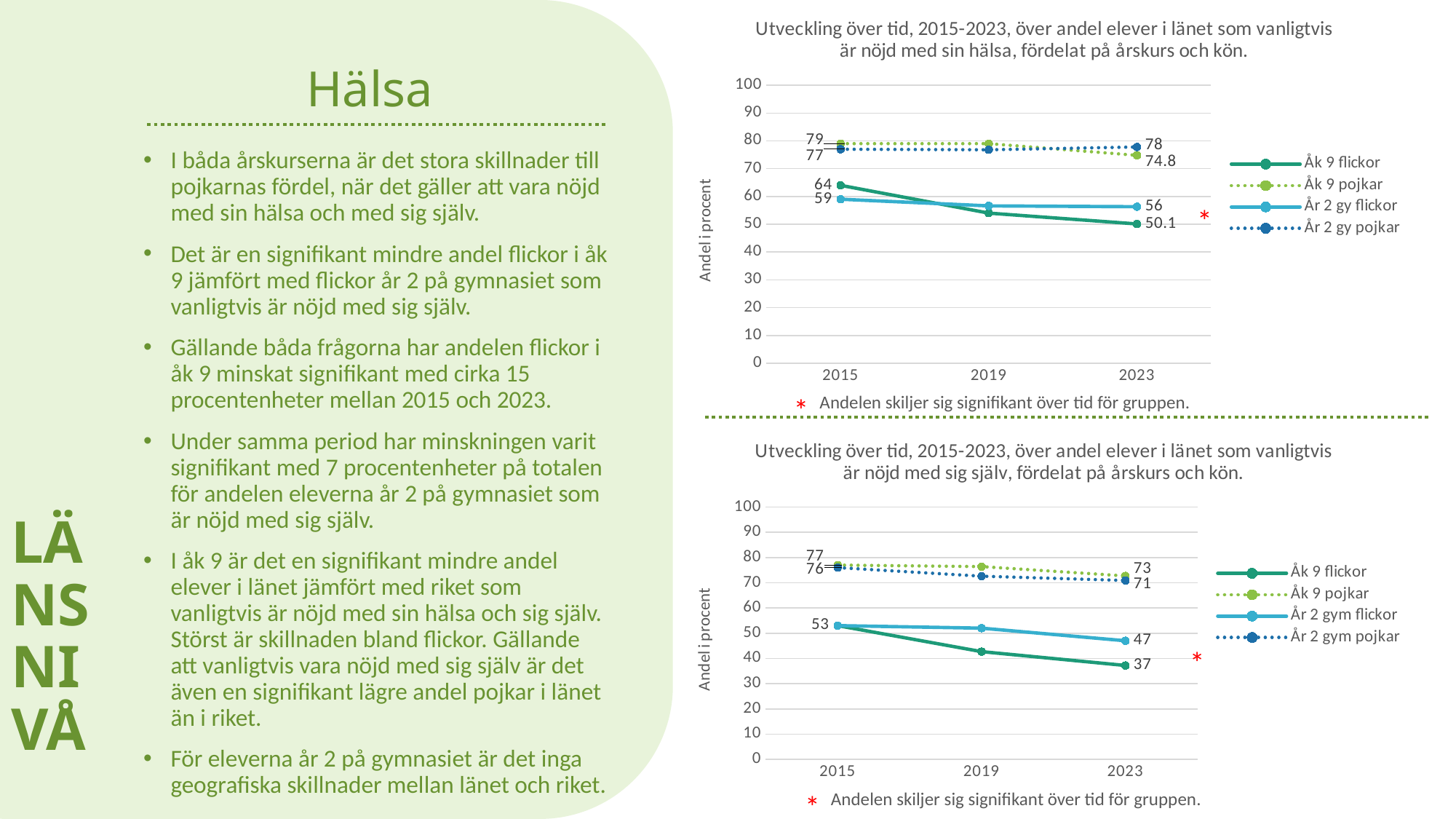
In the bottom chart, which series has the lowest value in 2023? Åk 9 flickor In the top chart, which series has the highest value in 2023? År 2 gy pojkar In the bottom chart, what is the value for År 2 gym pojkar in 2023? 71 In the top chart, by how much did the value for Åk 9 flickor change between 2015 and 2023? 13.9 In the top chart, how many series does the legend list? 4 In the bottom chart, is the value for Åk 9 flickor in 2019 greater or less than 50? less In the top chart, what is the value for Åk 9 pojkar in 2015? 79 In the bottom chart, what is the value for Åk 9 flickor in 2023? 37 In the top chart, what is the value for År 2 gy flickor in 2023? 56 In the top chart, what is the value for Åk 9 flickor in 2023? 50.1 What kind of chart is the bottom chart? line chart In the top chart, does the value for Åk 9 flickor rise or fall from 2015 to 2023? fall